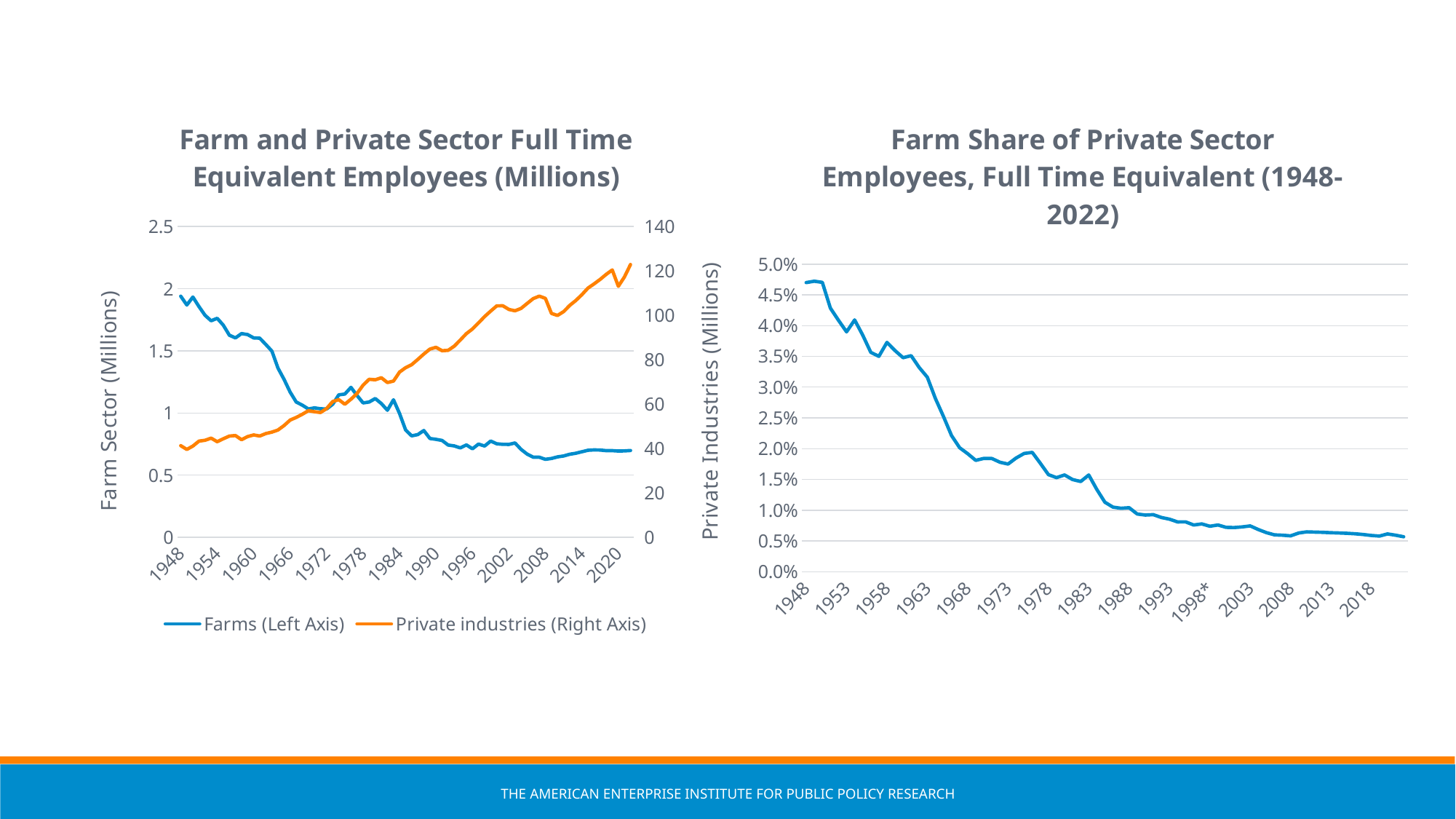
In the left chart, how many series does the legend list? 2 In the left chart, is the value for Private industries in 2020 greater or less than 100 million? greater What kind of chart is the left chart, 'Farm and Private Sector Full Time Equivalent Employees (Millions)'? Line chart In the right chart, is the farm share in 2018 greater or less than 1.0%? less In the left chart, does the Private industries series rise or fall from 1948 to 2020? Rise In the left chart, which series is plotted against the right axis according to the legend? Private industries In the left chart, does the Farms series rise or fall from 1948 to 2020? Fall In the right chart, is the farm share in 1948 greater or less than 4.0%? greater What kind of chart is the right chart, 'Farm Share of Private Sector Employees, Full Time Equivalent (1948-2022)'? Line chart In the left chart, what is the label of the left vertical axis? Farm Sector (Millions) In the right chart, does the farm share of private sector employees rise or fall from 1948 to 2022? Fall